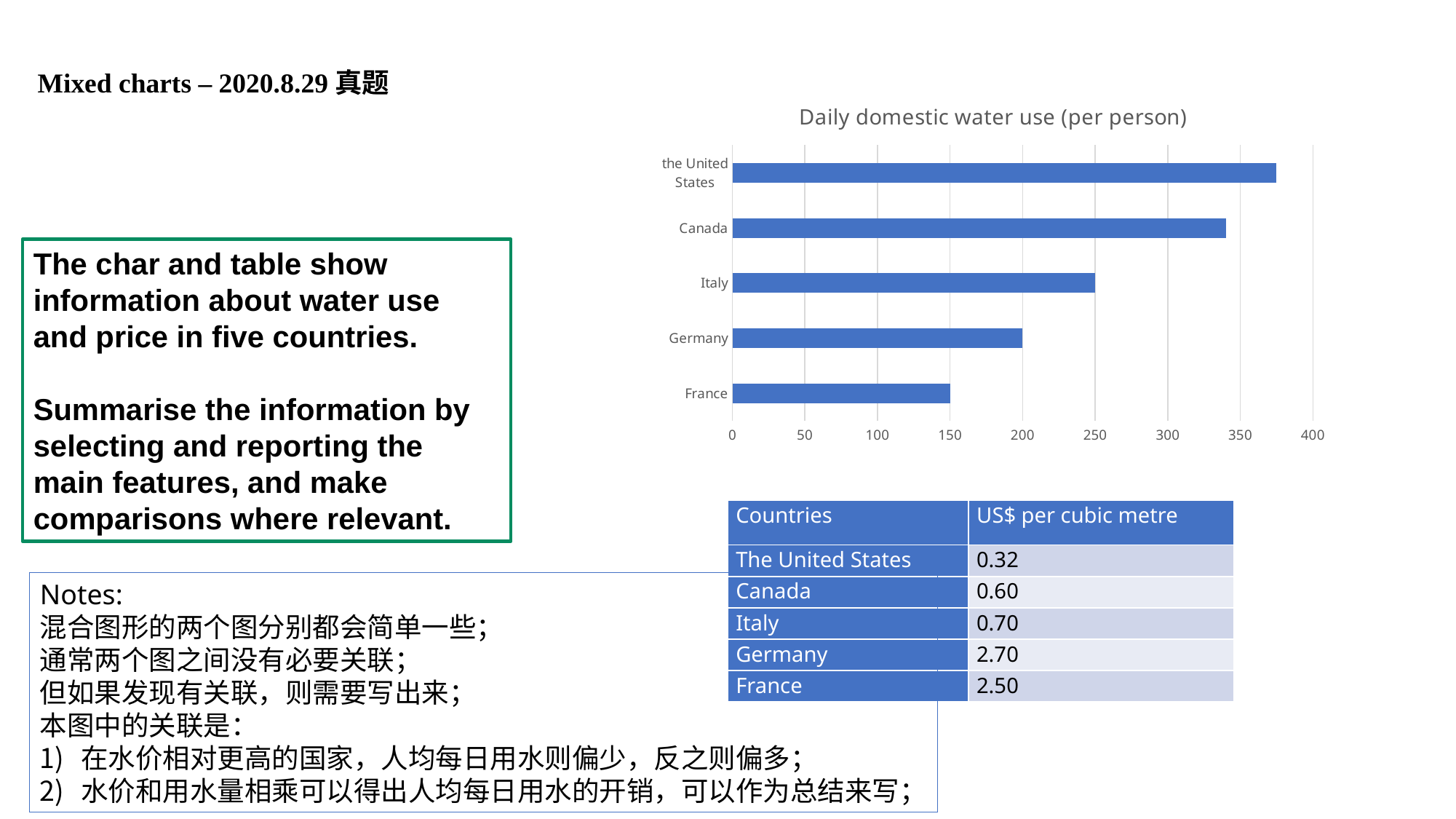
What type of chart is shown on the slide? bar chart Is the value for Italy greater or less than 300? less Which has a lower daily domestic water use per person, Germany or France? France Is the value for the United States greater or less than 350? greater Is the value for France greater or less than 200? less How many countries are shown in the chart? 5 What is the title of the chart? Daily domestic water use (per person) Which country has the lowest daily domestic water use per person? France Which country has the highest daily domestic water use per person? the United States Which has a higher daily domestic water use per person, Canada or Italy? Canada What is the maximum value shown on the horizontal axis of the chart? 400